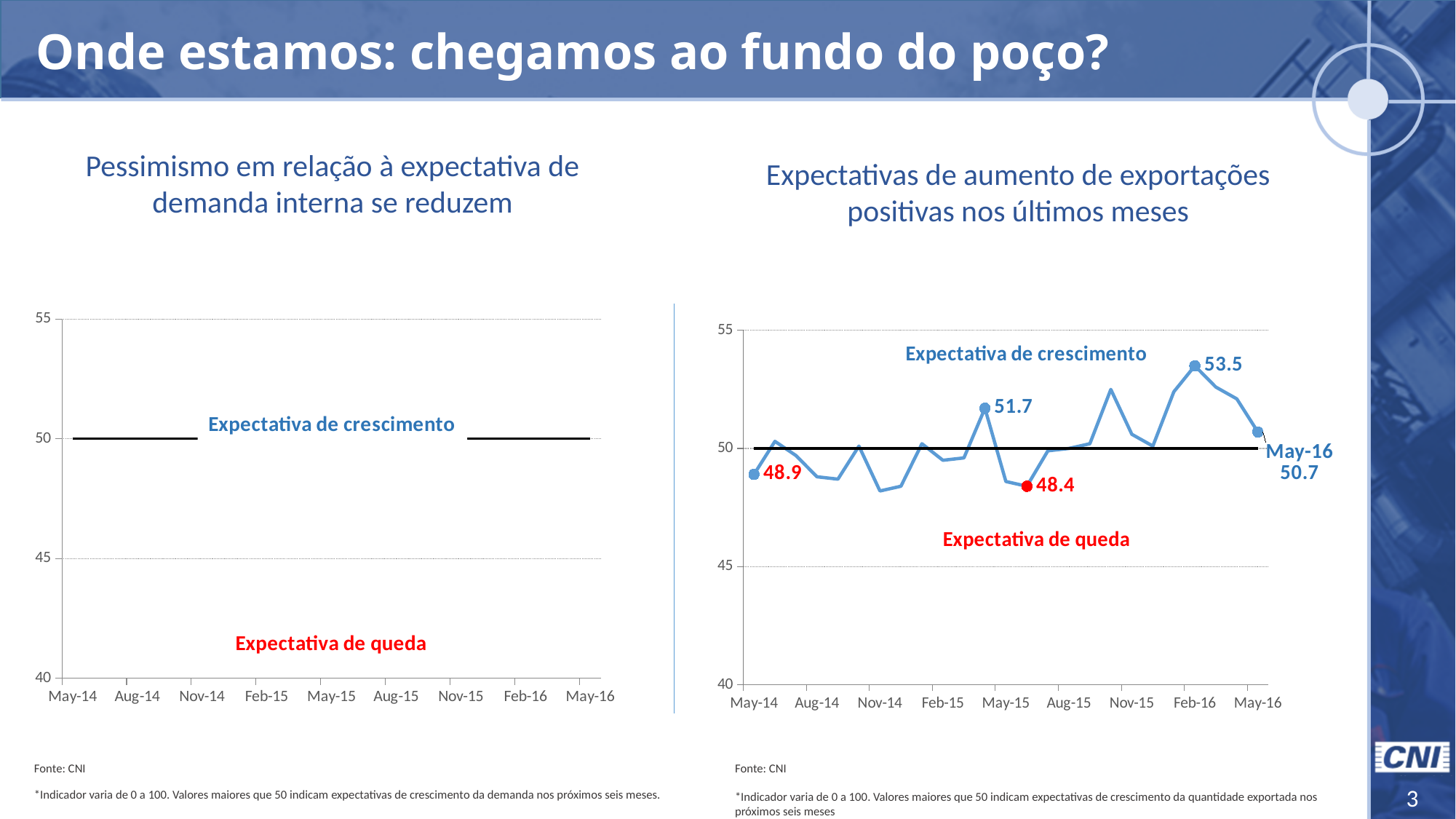
On the right chart, what is the difference between the Feb-16 peak value (53.5) and the May-16 value (50.7)? 2.8 On the right chart, what is the lowest labelled value on the line? 48.4 On the right chart, is the value for Aug-14 greater or less than 50? less On the right chart, what colour is the label 'Expectativa de queda'? red On the right chart, what is the difference between the highest labelled value (53.5) and the lowest labelled value (48.4)? 5.1 What kind of chart is the right chart? line chart On the right chart, at what value is the horizontal black reference line drawn? 50 On the right chart, what is the value labelled at May-14? 48.9 On the right chart, what is the highest labelled value on the line? 53.5 On the right chart, does the line rise or fall between Feb-16 and May-16? fall On the right chart, which is larger: the value at May-14 or the value at May-16? May-16 On the right chart (Expectativas de aumento de exportações), what is the value labelled for May-16? 50.7